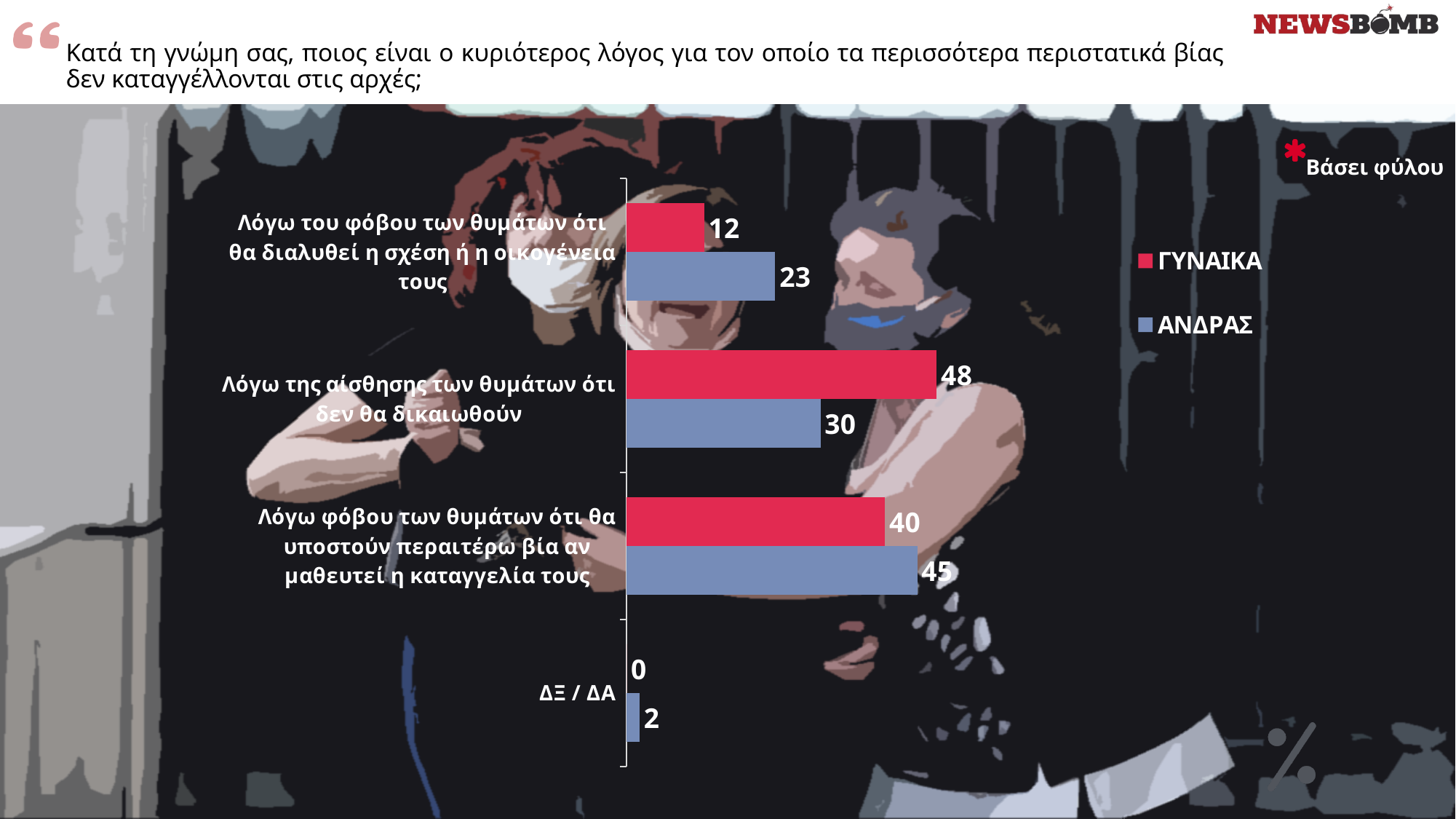
Which colour represents ΓΥΝΑΙΚΑ in the legend? Red What is the value for ΓΥΝΑΙΚΑ for 'Λόγω της αίσθησης των θυμάτων ότι δεν θα δικαιωθούν'? 48 Which category has the lowest value for ΓΥΝΑΙΚΑ? ΔΞ / ΔΑ What is the value for ΑΝΔΡΑΣ for 'ΔΞ / ΔΑ'? 2 For 'Λόγω φόβου των θυμάτων ότι θα υποστούν περαιτέρω βία αν μαθευτεί η καταγγελία τους', which is larger: ΓΥΝΑΙΚΑ or ΑΝΔΡΑΣ? ΑΝΔΡΑΣ What is the value for ΑΝΔΡΑΣ for 'Λόγω του φόβου των θυμάτων ότι θα διαλυθεί η σχέση ή η οικογένεια τους'? 23 How many categories are shown in the chart? 4 What is the difference between the ΓΥΝΑΙΚΑ and ΑΝΔΡΑΣ values for 'Λόγω της αίσθησης των θυμάτων ότι δεν θα δικαιωθούν'? 18 Which category has the highest value for ΓΥΝΑΙΚΑ? Λόγω της αίσθησης των θυμάτων ότι δεν θα δικαιωθούν How many series does the legend list? 2 What kind of chart is shown on the slide? Bar chart Which category has the highest value for ΑΝΔΡΑΣ? Λόγω φόβου των θυμάτων ότι θα υποστούν περαιτέρω βία αν μαθευτεί η καταγγελία τους